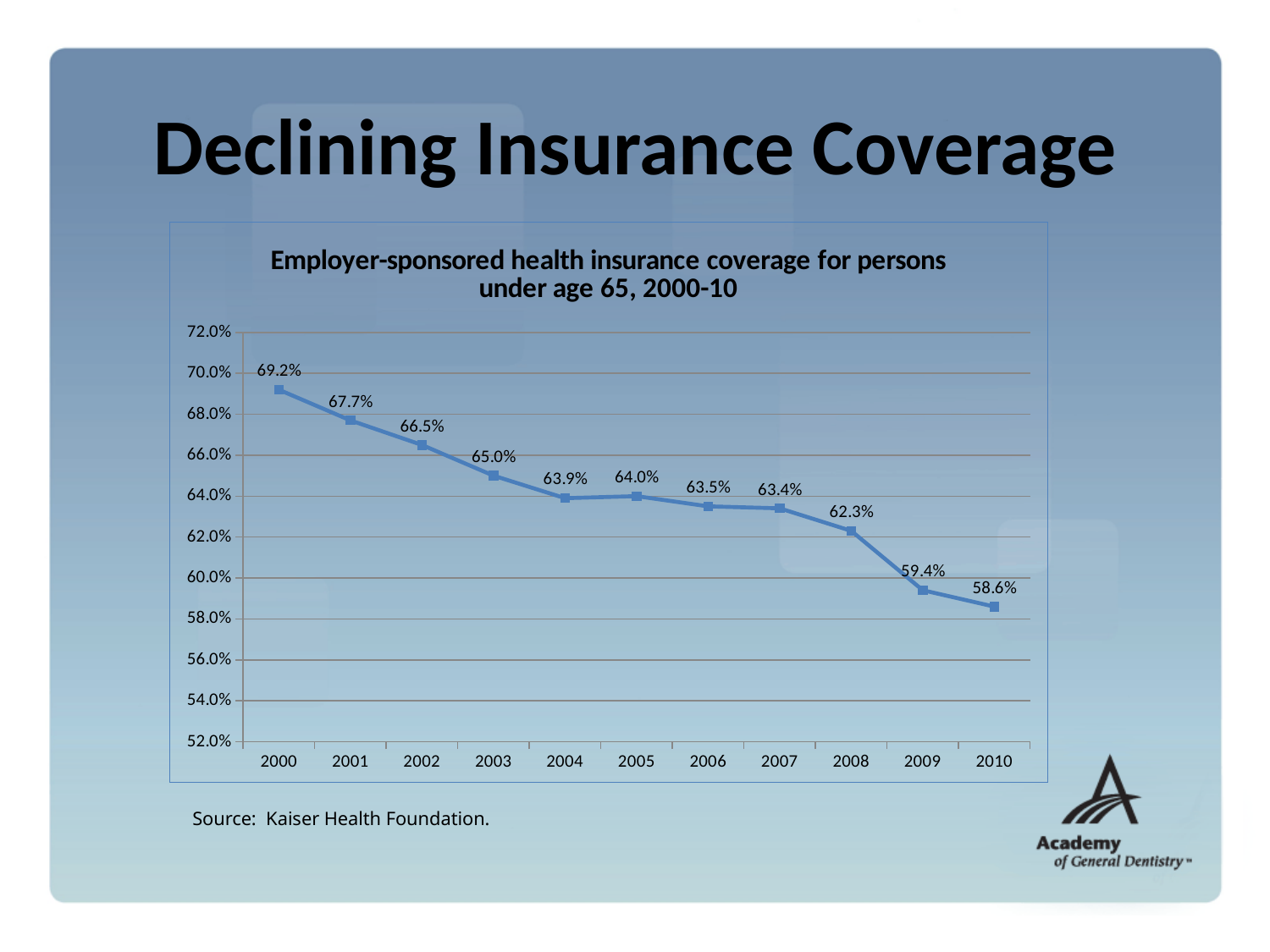
How many years are plotted on the chart? 11 Do the coverage values generally rise or fall from 2000 to 2010? Fall What kind of chart is shown on the slide? Line chart What is the coverage value shown for 2005? 64.0% Is the coverage value for 2009 greater or less than 60.0%? less Which year has the lowest coverage value? 2010 What is the difference between the coverage values for 2008 and 2009? 2.9% What is the employer-sponsored health insurance coverage value for 2000? 69.2% What is the difference between the coverage values for 2000 and 2010? 10.6% Which year has the highest coverage value? 2000 What is the coverage value shown for 2010? 58.6% Which year has a higher coverage value, 2004 or 2005? 2005